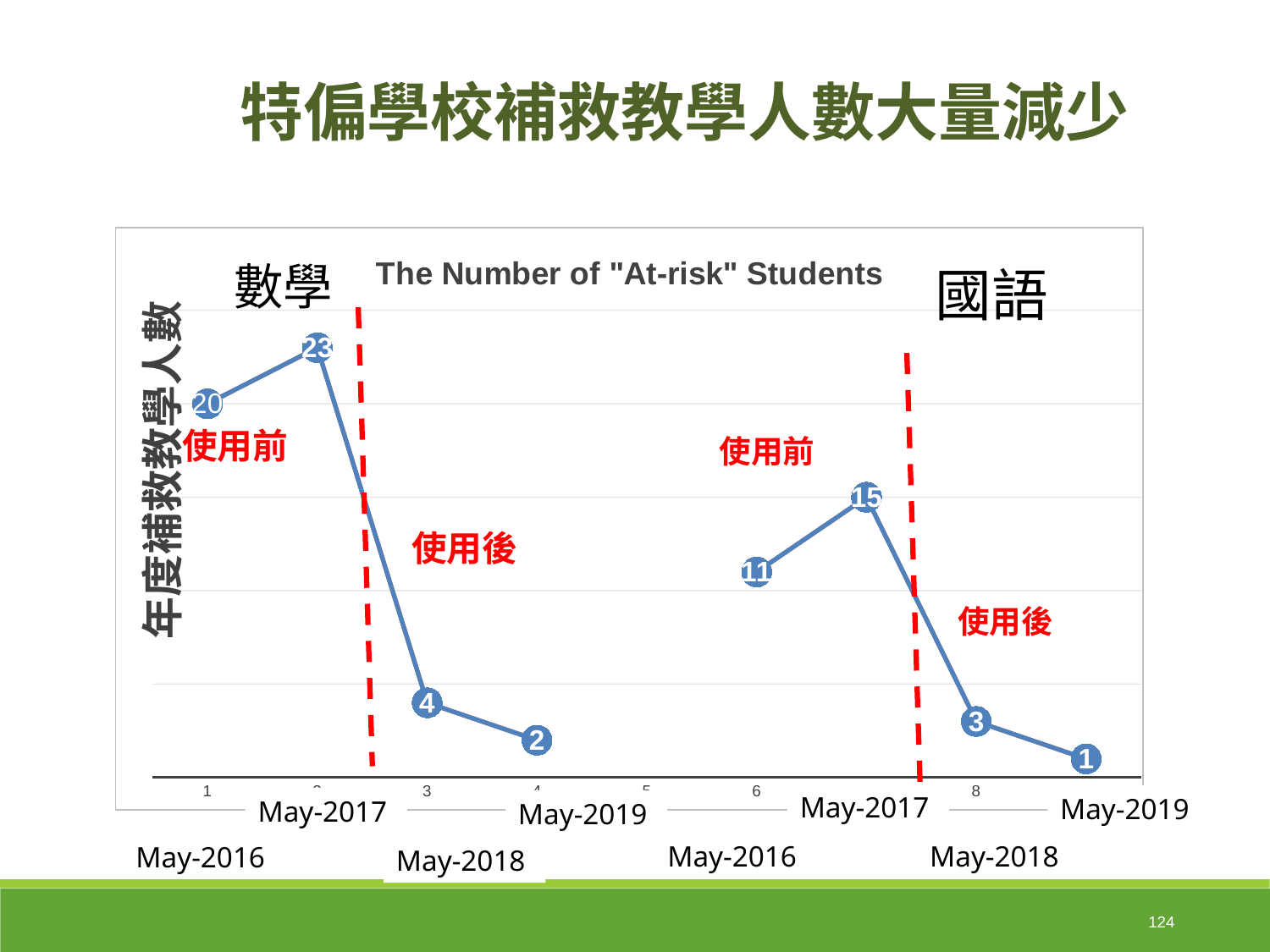
In the 數學 section of the chart, which point has the highest value? May-2017 In the 數學 section of the chart, what is the difference between the May-2017 value and the May-2018 value? 19 In the 國語 section of the chart, which point has the lowest value? May-2019 In the 國語 section of the chart, what is the value for May-2018? 3 What kind of chart is shown on the slide? line chart What is the title of the chart? The Number of "At-risk" Students In the 國語 section of the chart, what is the difference between the May-2017 value and the May-2019 value? 14 In the 數學 section of the chart, what is the value for May-2019? 2 In the 數學 section of the chart, what is the value for May-2017? 23 In the 國語 section of the chart, do the values rise or fall from May-2017 to May-2019? fall In the 國語 section of the chart, what is the value for May-2016? 11 Which is larger: the May-2016 value in the 數學 section or the May-2016 value in the 國語 section? 數學